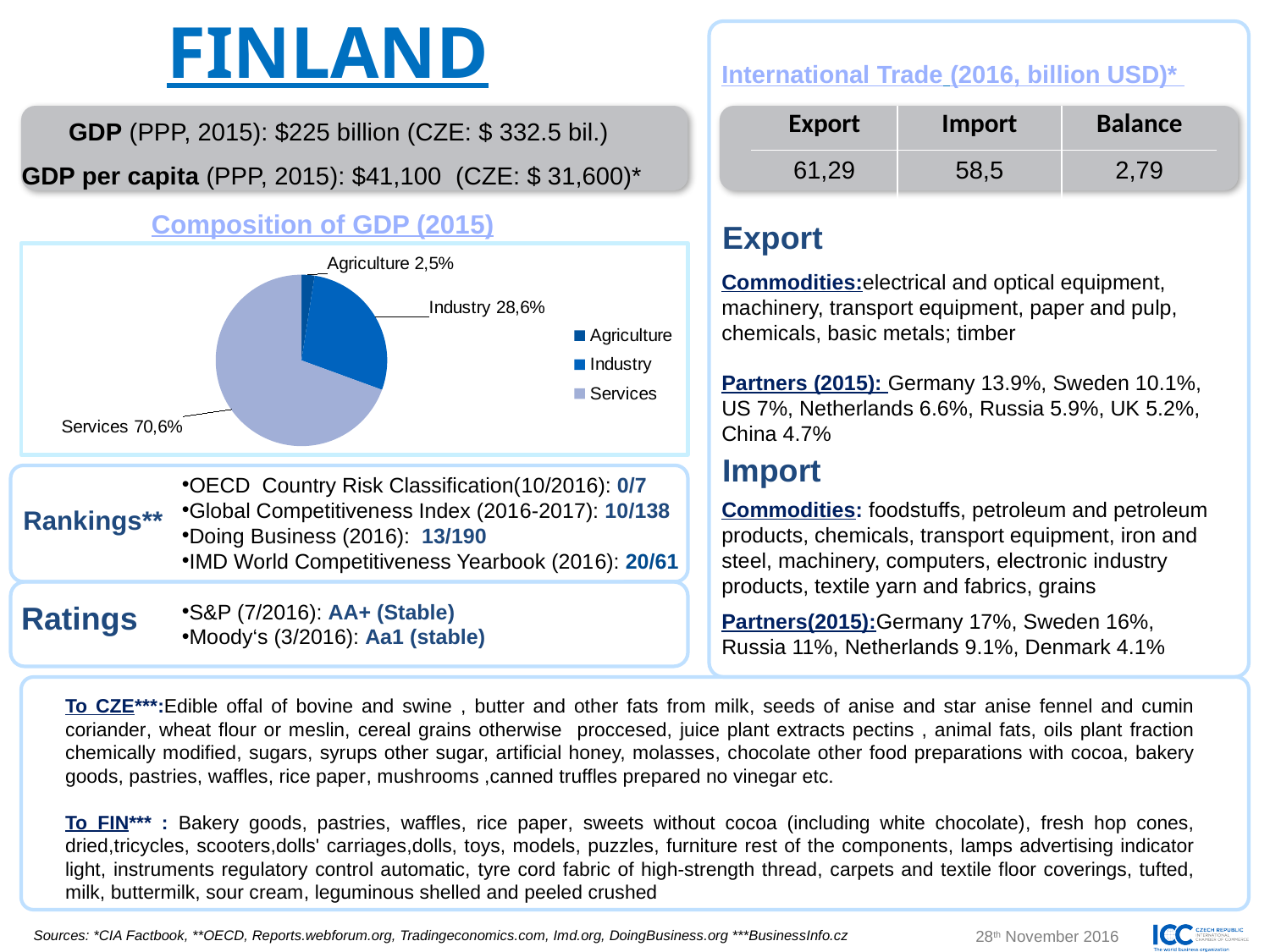
How many slices does the Composition of GDP (2015) pie chart have? 3 What is the share of Services in the Composition of GDP (2015) pie chart? 70,6% In the Composition of GDP (2015) pie chart, which is larger: Industry or Agriculture? Industry Which sector has the smallest slice in the Composition of GDP (2015) pie chart? Agriculture What is the share of Agriculture in the Composition of GDP (2015) pie chart? 2,5% In the Composition of GDP (2015) pie chart, what is the difference in percentage points between Industry and Agriculture? 26,1 percentage points What type of chart is used to show the Composition of GDP (2015)? pie chart In the Composition of GDP (2015) pie chart, what is the difference in percentage points between Services and Industry? 42 percentage points Which sector has the largest slice in the Composition of GDP (2015) pie chart? Services What is the title of the pie chart on the slide? Composition of GDP (2015) How many entries does the legend of the Composition of GDP (2015) pie chart list? 3 What is the share of Industry in the Composition of GDP (2015) pie chart? 28,6%